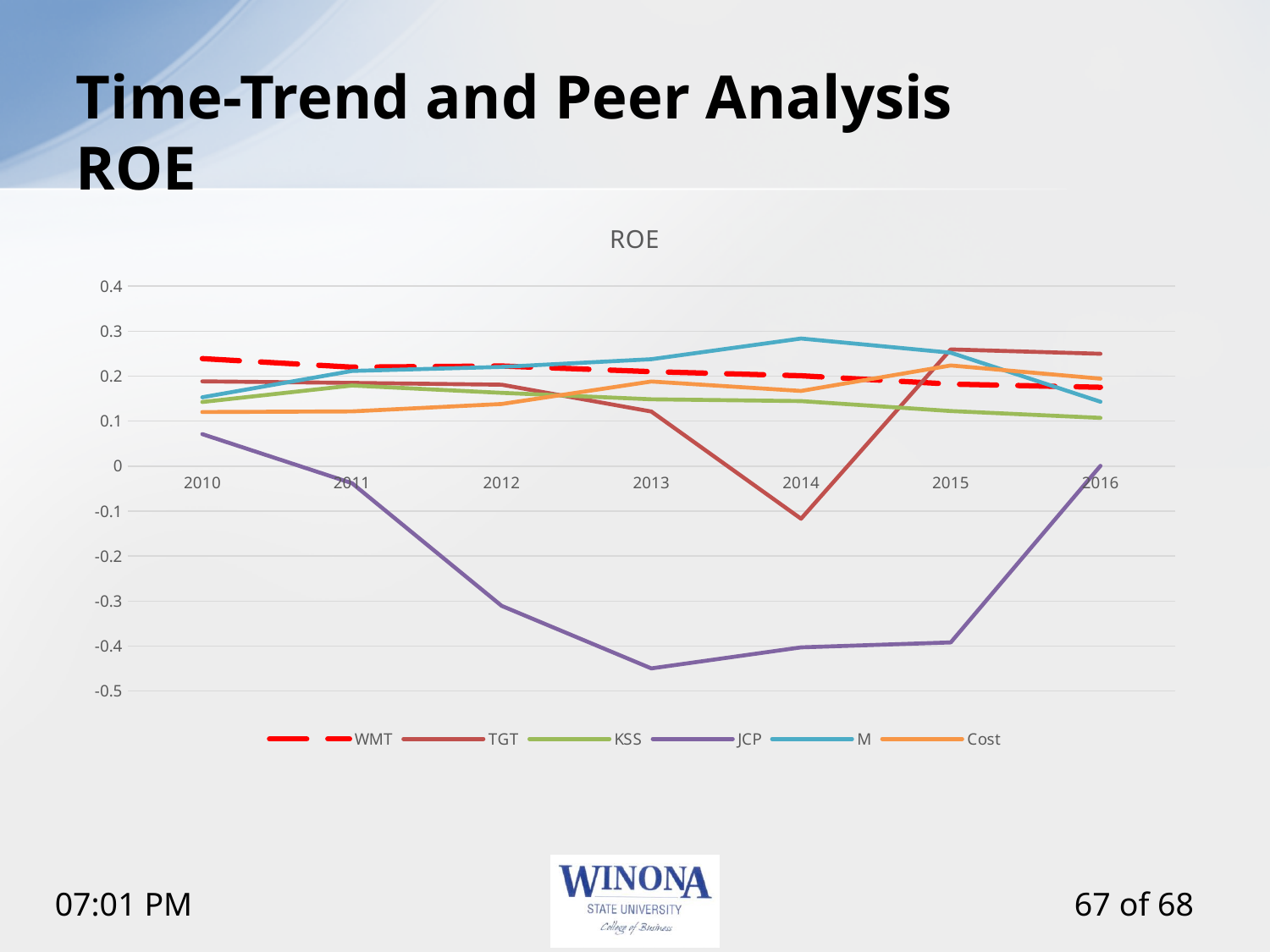
Is the ROE value for M in 2014 greater or less than 0.2? greater Which series is drawn with a dashed line in the ROE chart? WMT Which series has the lowest ROE in 2013? JCP How many years are shown on the x axis of the ROE chart? 7 In 2016, which series has the larger ROE, TGT or M? TGT How many series does the legend of the ROE chart list? 6 Is the ROE value for JCP in 2013 greater or less than -0.4? less Which series has the highest ROE in 2014? M Does the ROE for WMT rise or fall from 2010 to 2016? fall Is the ROE value for TGT in 2014 greater or less than 0? less Does the ROE for JCP rise or fall from 2010 to 2013? fall What kind of chart is shown on the slide? line chart